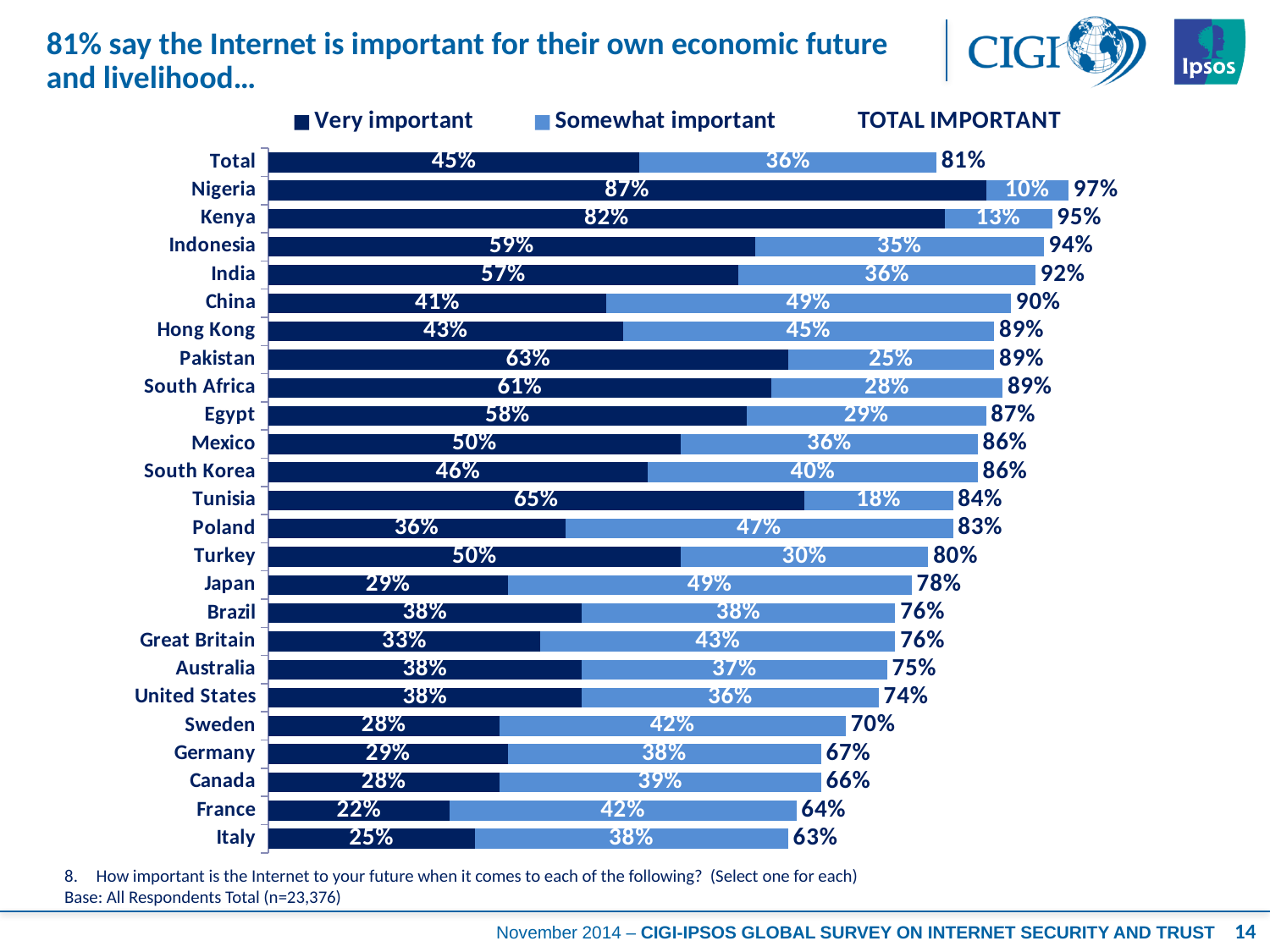
What is the total of the stacked bar for Mexico (Very important plus Somewhat important)? 86% What kind of chart is shown on the slide? Stacked bar chart What is the "Somewhat important" value for China? 49% Which series is shown in the darker blue colour? Very important What percentage of respondents in Nigeria say the Internet is "Very important" for their economic future? 87% Which country has the lowest TOTAL IMPORTANT value? Italy Which has a larger "Somewhat important" value, Tunisia or Sweden? Sweden Which country has the highest "Very important" percentage? Nigeria What is the difference between the "Very important" values for Kenya and Poland? 46% How many series does the legend list? 3 What is the TOTAL IMPORTANT value shown for Japan? 78% How many categories (rows) are plotted in the chart? 25